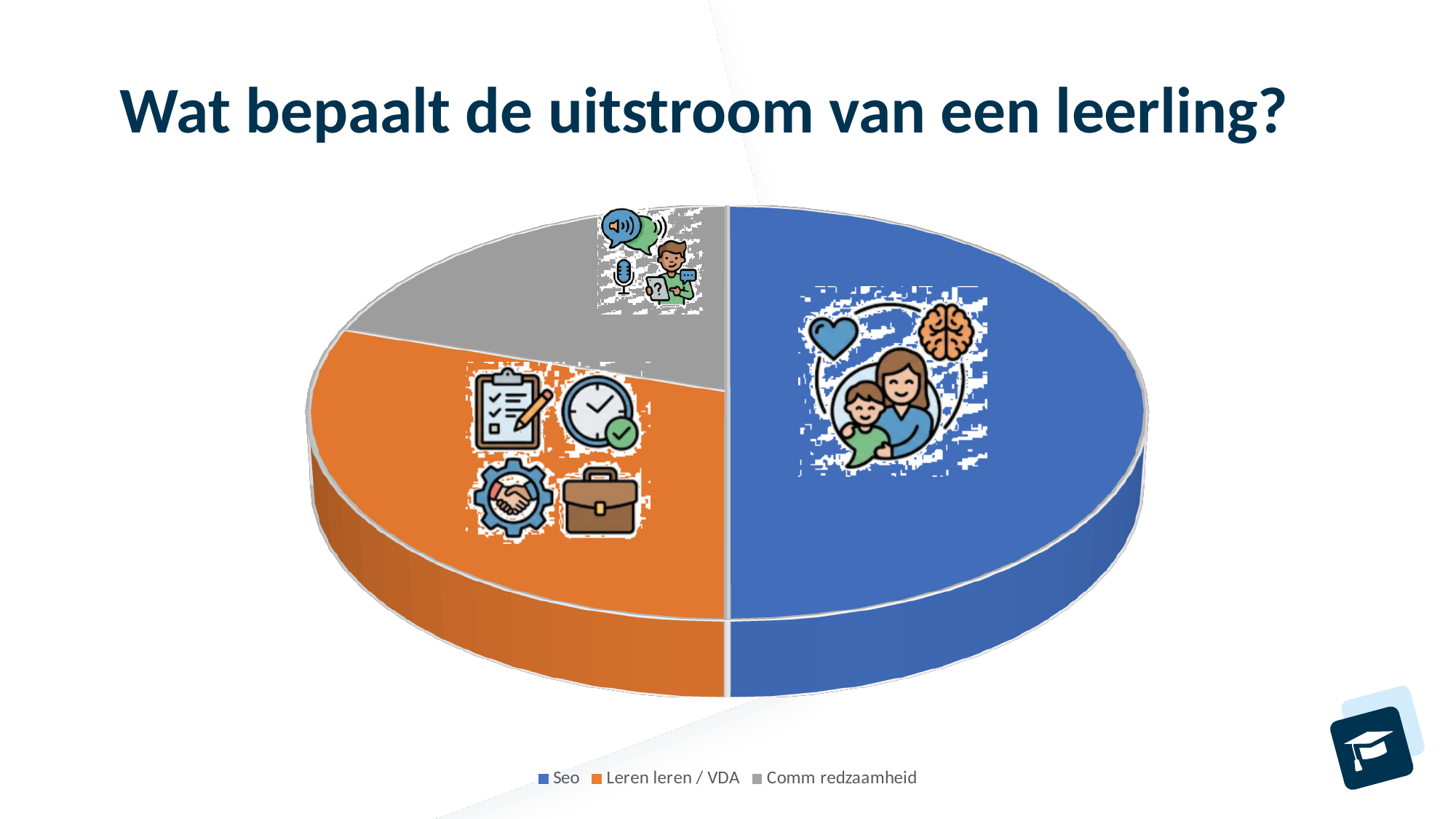
Which slice is larger, Leren leren / VDA or Comm redzaamheid? Leren leren / VDA What is the title of the slide containing the pie chart? Wat bepaalt de uitstroom van een leerling? What kind of chart is shown on the slide? pie chart What colour is the slice for Leren leren / VDA? orange Which slice is smaller, Seo or Comm redzaamheid? Comm redzaamheid Which slice is larger, Seo or Leren leren / VDA? Seo Which category has the smallest slice of the pie chart? Comm redzaamheid How many slices does the pie chart have? 3 Which category has the largest slice of the pie chart? Seo How many entries does the legend of the pie chart list? 3